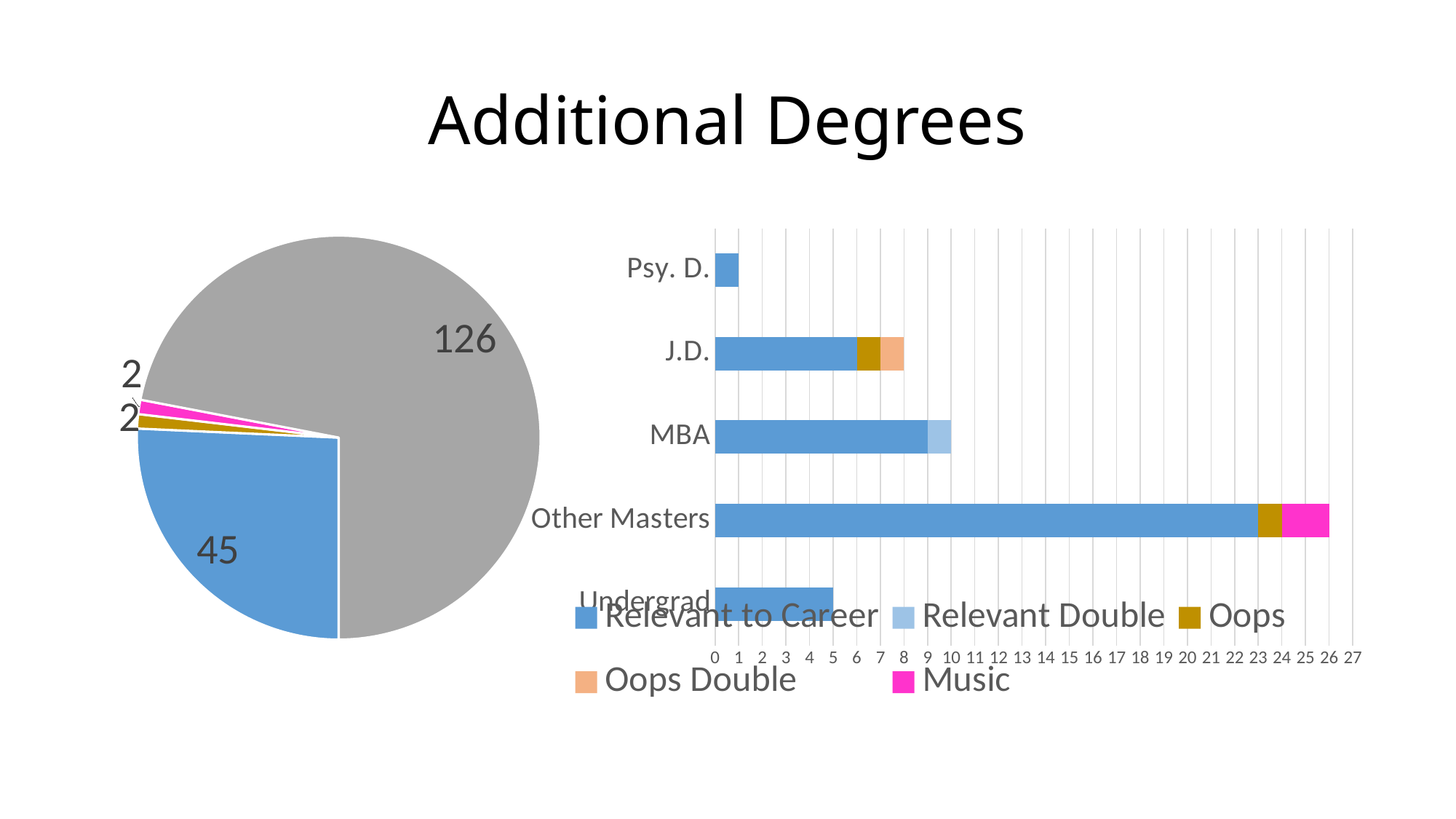
In the bar chart, which is larger, the total bar for J.D. or for Undergrad? J.D. In the pie chart, what is the value of the blue slice? 45 In the pie chart, what is the largest labelled value? 126 In the bar chart, how many categories are shown on the vertical axis? 5 In the bar chart, is the total for MBA greater or less than 5? greater In the bar chart, how many series does the legend list? 5 In the bar chart, which category has the shortest total bar? Psy. D. What type of chart is on the left side of the slide? pie chart What type of chart is on the right side of the slide? bar chart In the bar chart, which category has the longest total bar? Other Masters In the pie chart, what is the difference between the grey slice (126) and the blue slice (45)? 81 In the bar chart, what is the total length of the Other Masters bar? 26